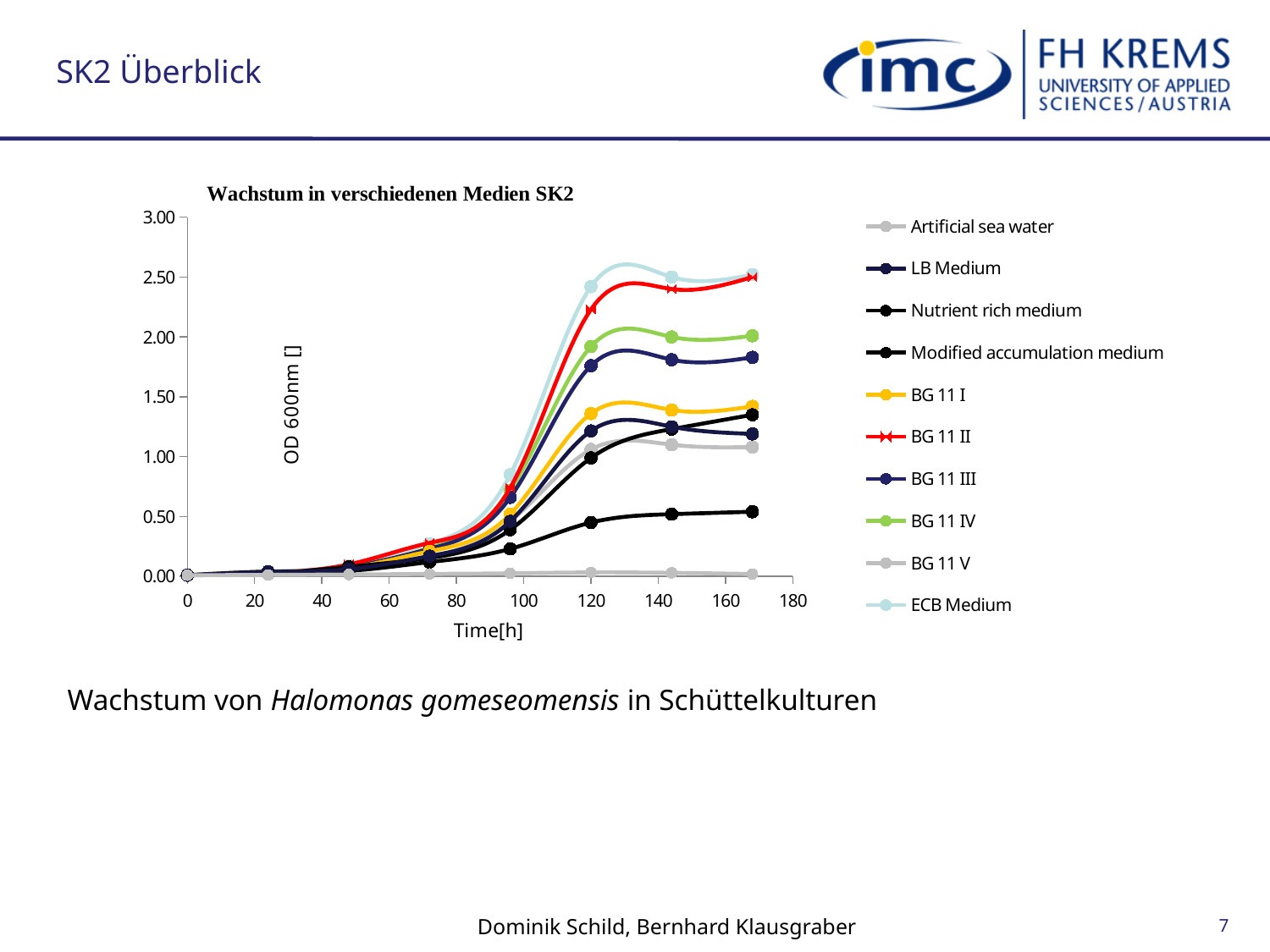
Does the ECB Medium series rise or fall overall from 0 h to 168 h? rise What is the label of the x axis? Time[h] At 168 h, which is larger: BG 11 IV or BG 11 I? BG 11 IV What kind of chart is shown on the slide? line chart What is the title of the chart? Wachstum in verschiedenen Medien SK2 Is the value for Artificial sea water at 168 h greater or less than 0.50? less How many series does the legend list? 10 How many time points are plotted for each series? 8 Is the value for BG 11 III at 168 h greater or less than 1.50? greater Which series has the lowest values across the whole time range? Artificial sea water Is the value for ECB Medium at 120 h greater or less than 2.00? greater